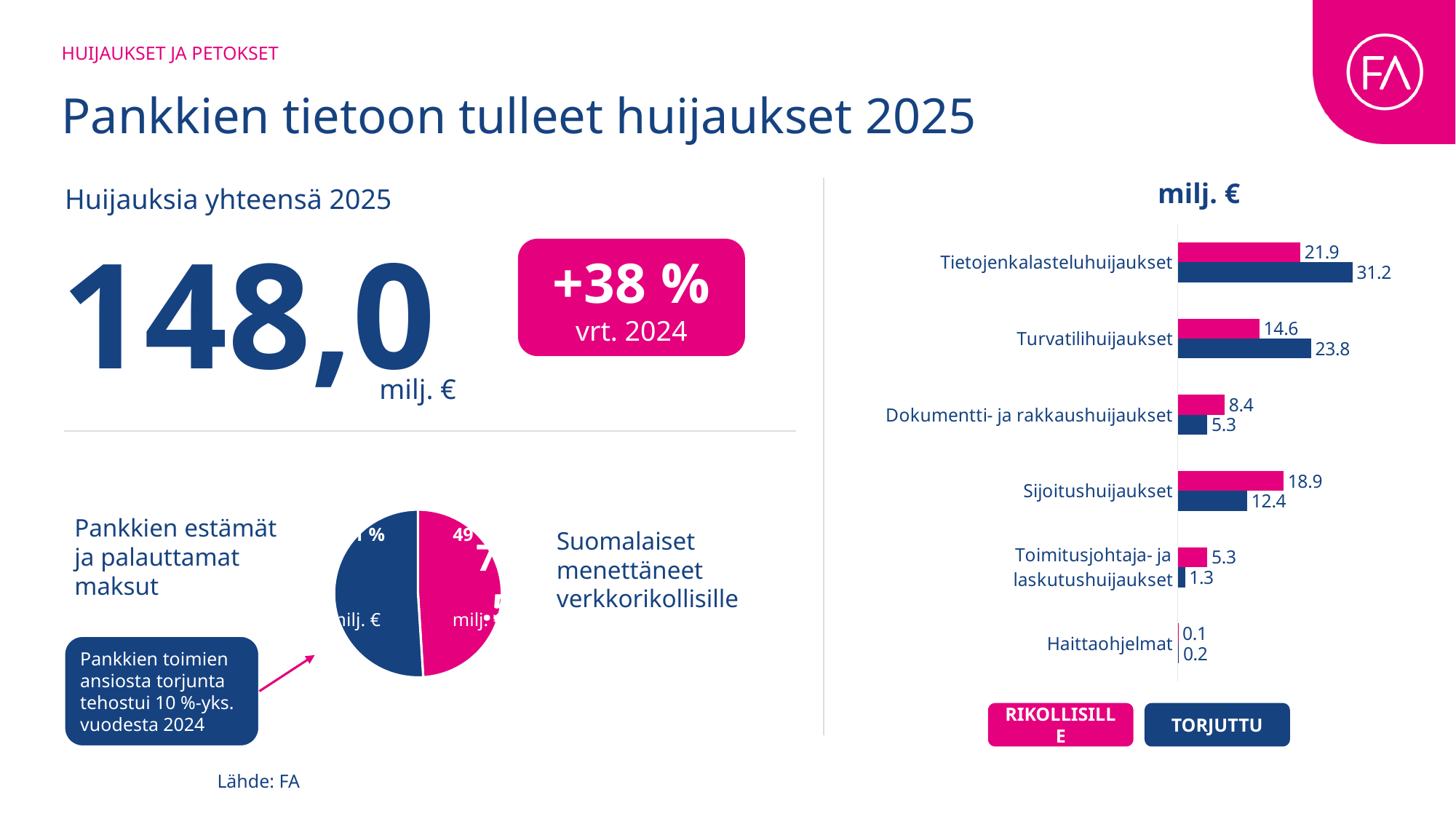
In the bar chart on the right, what is the TORJUTTU value for Turvatilihuijaukset? 23.8 In the bar chart on the right, which category has the lowest RIKOLLISILLE value? Haittaohjelmat In the bar chart on the right, what colour are the TORJUTTU bars? Dark blue In the bar chart on the right, which is larger for Dokumentti- ja rakkaushuijaukset: the RIKOLLISILLE value or the TORJUTTU value? RIKOLLISILLE In the bar chart on the right, what is the difference between the TORJUTTU and RIKOLLISILLE values for Tietojenkalasteluhuijaukset? 9.3 In the bar chart on the right, what is the RIKOLLISILLE value for Tietojenkalasteluhuijaukset? 21.9 In the bar chart on the right, which category has the highest TORJUTTU value? Tietojenkalasteluhuijaukset In the bar chart on the right, which is larger for Sijoitushuijaukset: the RIKOLLISILLE value or the TORJUTTU value? RIKOLLISILLE How many series does the legend of the bar chart on the right list? 2 In the bar chart on the right, what is the TORJUTTU value for Toimitusjohtaja- ja laskutushuijaukset? 1.3 How many categories are shown in the bar chart on the right? 6 What kind of chart is shown on the right side of the slide? Bar chart